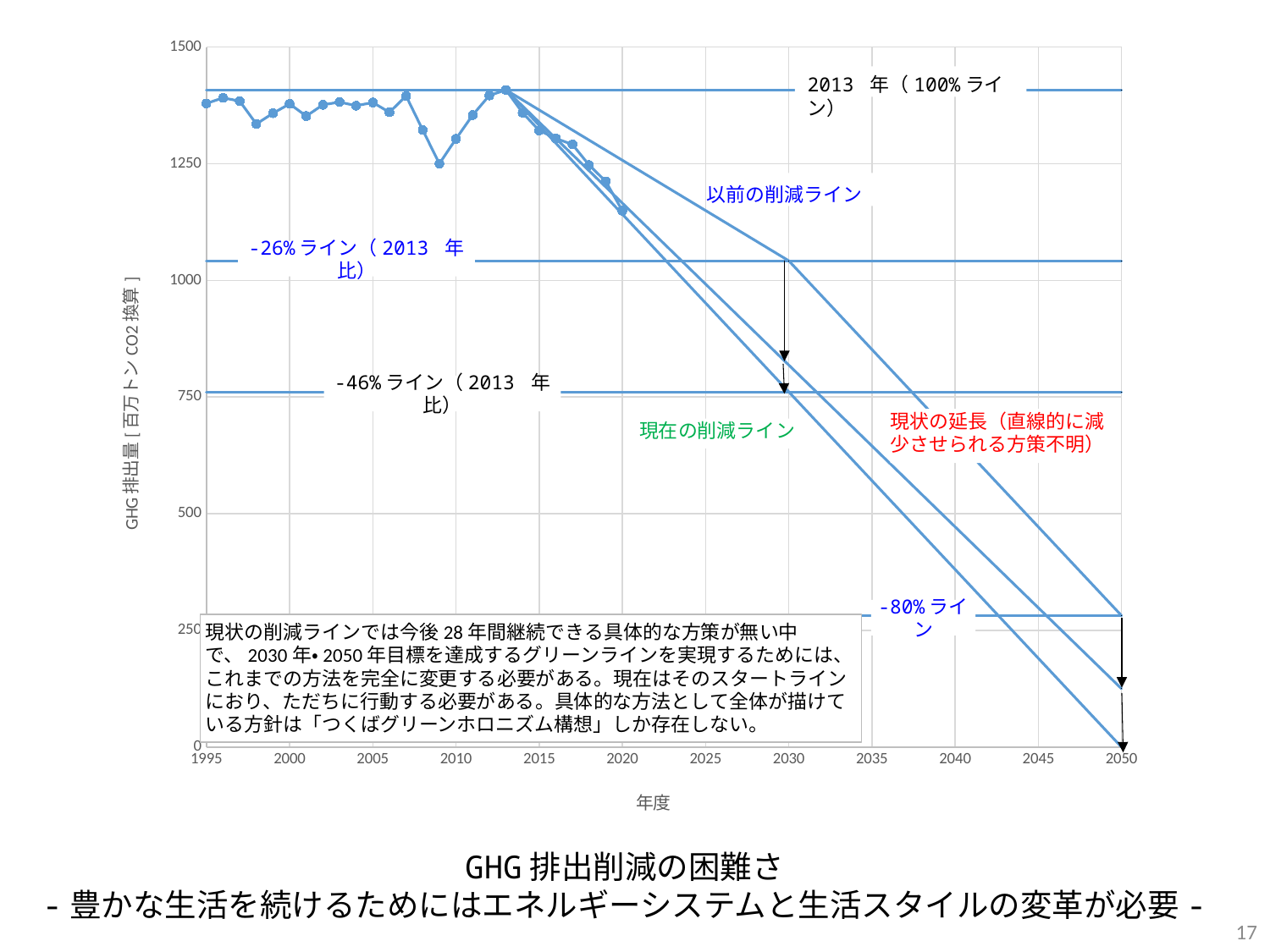
What kind of chart is shown on the slide? line chart In which year do the plotted data points reach their highest value? 2013 What is the label of the y axis of the chart? GHG 排出量 [ 百万トン CO2 換算 ] What is the label of the x axis of the chart? 年度 Do the plotted data points rise or fall between 2013 and 2020? fall In which year does the 以前の削減ライン reach the -26% ライン? 2030 Is the level of the -26% ライン greater or less than 1000? greater In which year between 1995 and 2013 do the plotted data points reach their lowest value? 2009 Is the plotted value for 1995 greater or less than 1250? greater Is the value of the 現状の延長 line in 2050 greater or less than 250? less In which year does the 現在の削減ライン reach 0? 2050